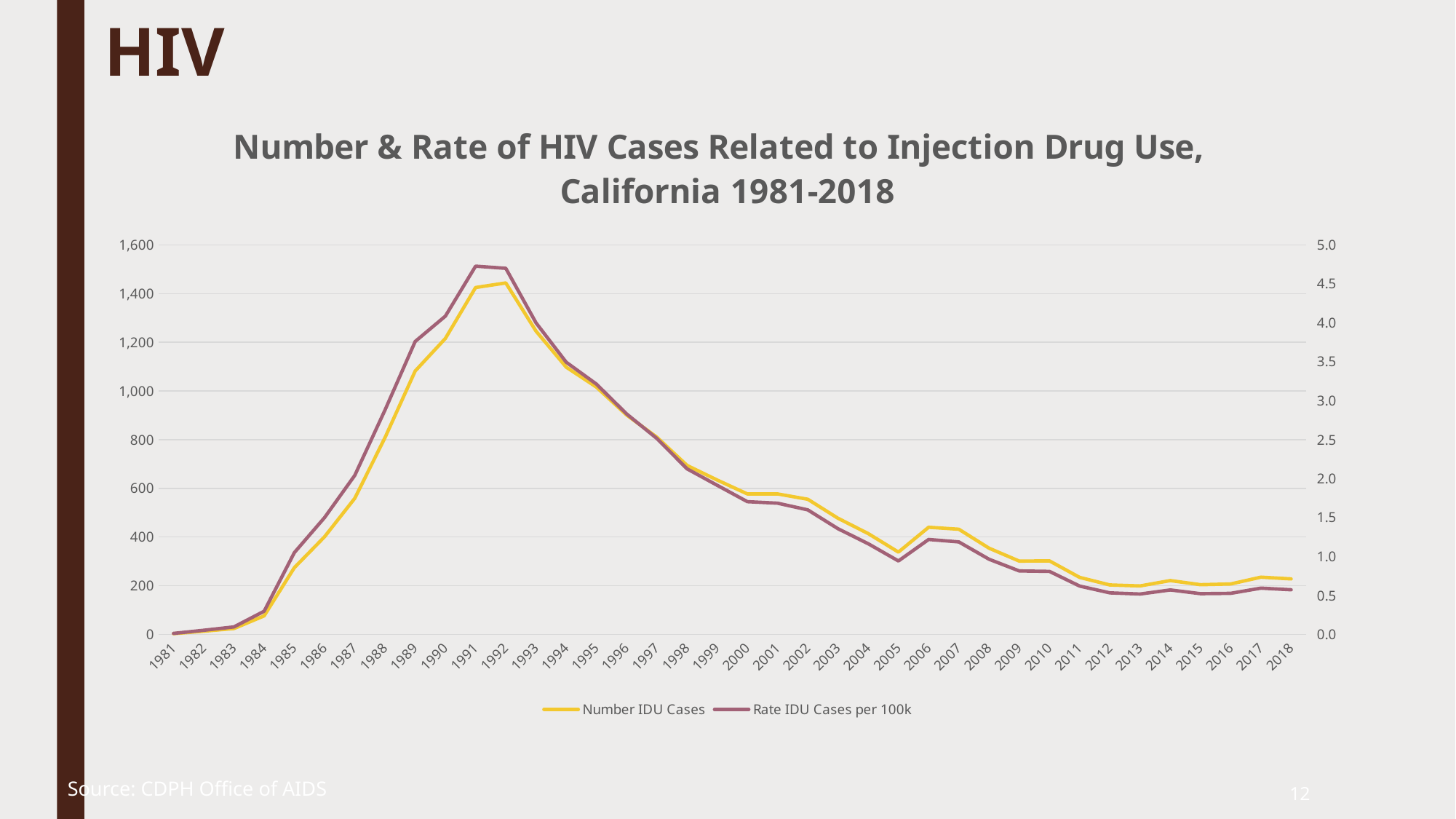
Is the value for Number IDU Cases in 1989 greater or less than 1,000? greater How many years are plotted along the x axis? 38 How many series does the legend list? 2 Is the value for Number IDU Cases in 2005 greater or less than 400? less Do the Number IDU Cases values rise or fall from 1992 to 2005? fall What is the title of the chart? Number & Rate of HIV Cases Related to Injection Drug Use, California 1981-2018 Is the value for Rate IDU Cases per 100k in 2000 greater or less than 1.5? greater In which year is the Number IDU Cases lowest? 1981 What kind of chart is shown on the slide? line chart Which series is drawn in yellow? Number IDU Cases